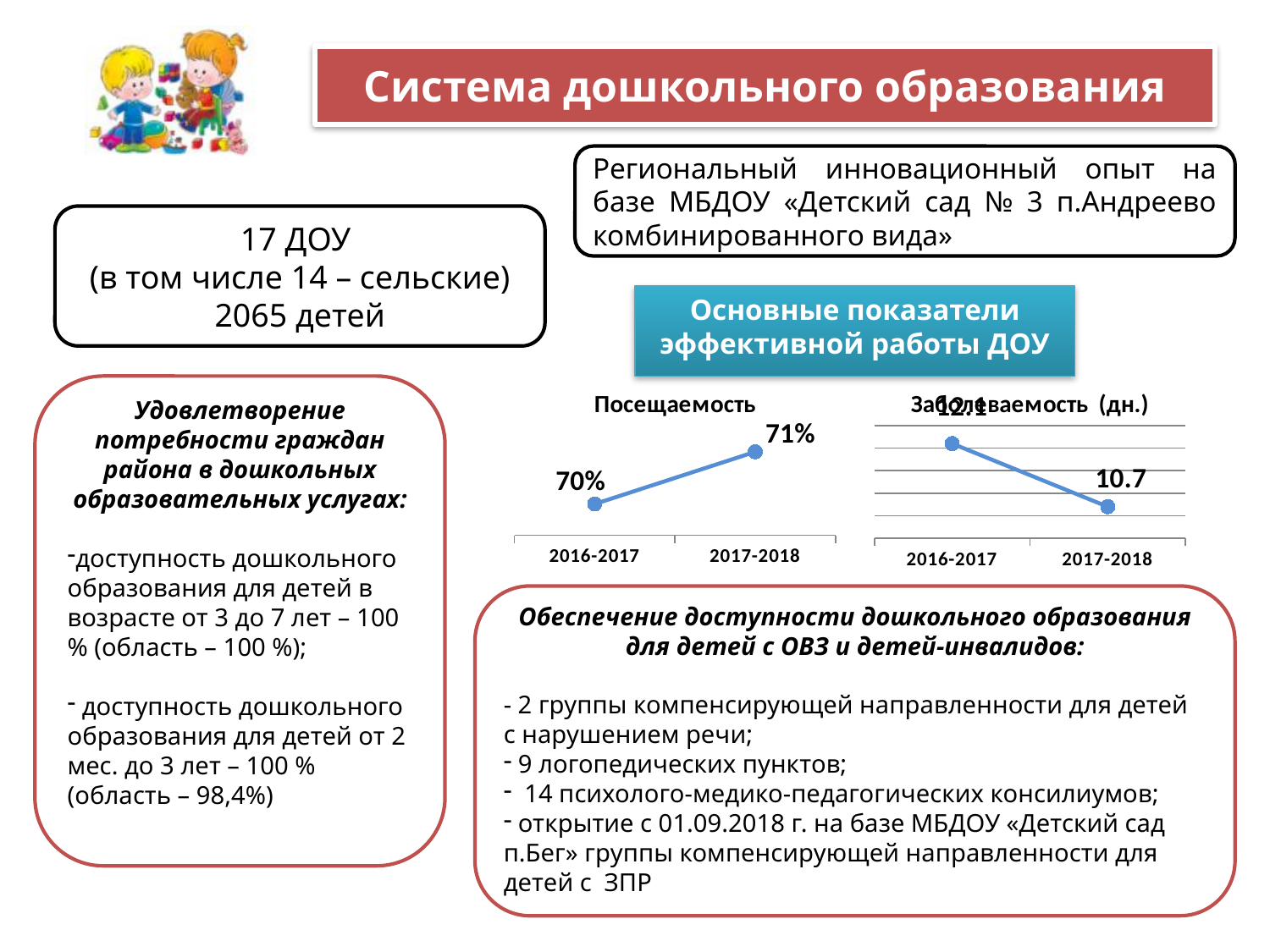
On the Посещаемость chart, what is the difference between the 2017-2018 and 2016-2017 values? 1% On the Заболеваемость (дн.) chart, what is the difference between the 2016-2017 and 2017-2018 values? 1.4 On the Заболеваемость (дн.) chart, which year has the lower value? 2017-2018 On the Посещаемость chart, what is the value for 2016-2017? 70% How many data points are plotted on the Заболеваемость (дн.) chart? 2 What kind of chart is the Посещаемость chart? line chart On the Посещаемость chart, which year has the higher value? 2017-2018 On the Посещаемость chart, do the values rise or fall from 2016-2017 to 2017-2018? rise On the Заболеваемость (дн.) chart, what is the value for 2016-2017? 12.1 On the Заболеваемость (дн.) chart, what is the value for 2017-2018? 10.7 On the Заболеваемость (дн.) chart, do the values rise or fall from 2016-2017 to 2017-2018? fall On the Посещаемость chart, what is the value for 2017-2018? 71%